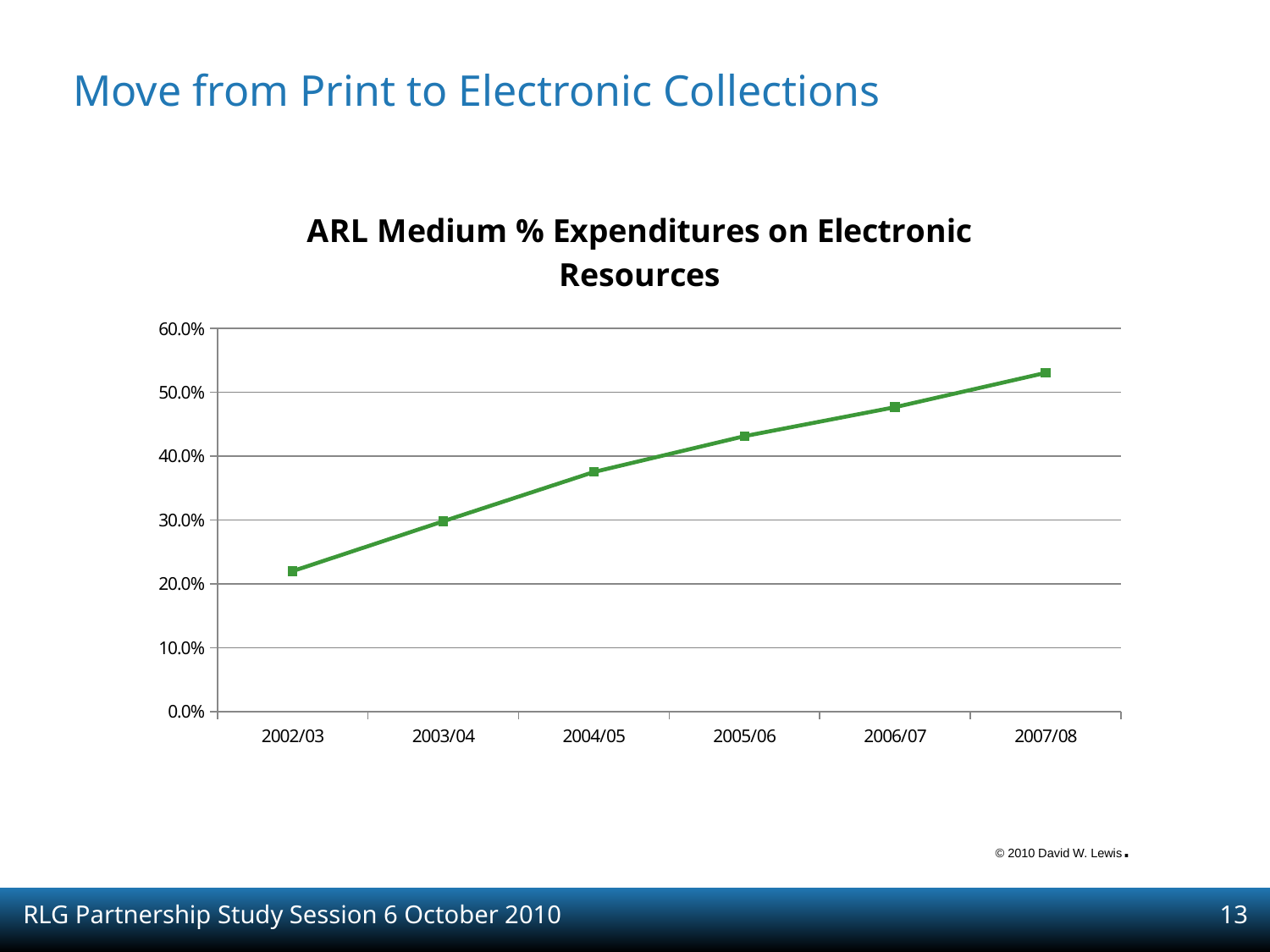
Which year has the highest percentage of expenditures on electronic resources? 2007/08 Is the value for 2005/06 greater or less than 40.0%? greater What type of chart is shown on the slide? line chart Is the value for 2007/08 greater or less than 50.0%? greater Is the value for 2002/03 greater or less than 20.0%? greater What is the title of the chart? ARL Medium % Expenditures on Electronic Resources Which is larger, the value for 2003/04 or the value for 2006/07? 2006/07 How many data points are plotted on the line? 6 Do the values rise or fall from 2002/03 to 2007/08? rise Which year has the lowest percentage of expenditures on electronic resources? 2002/03